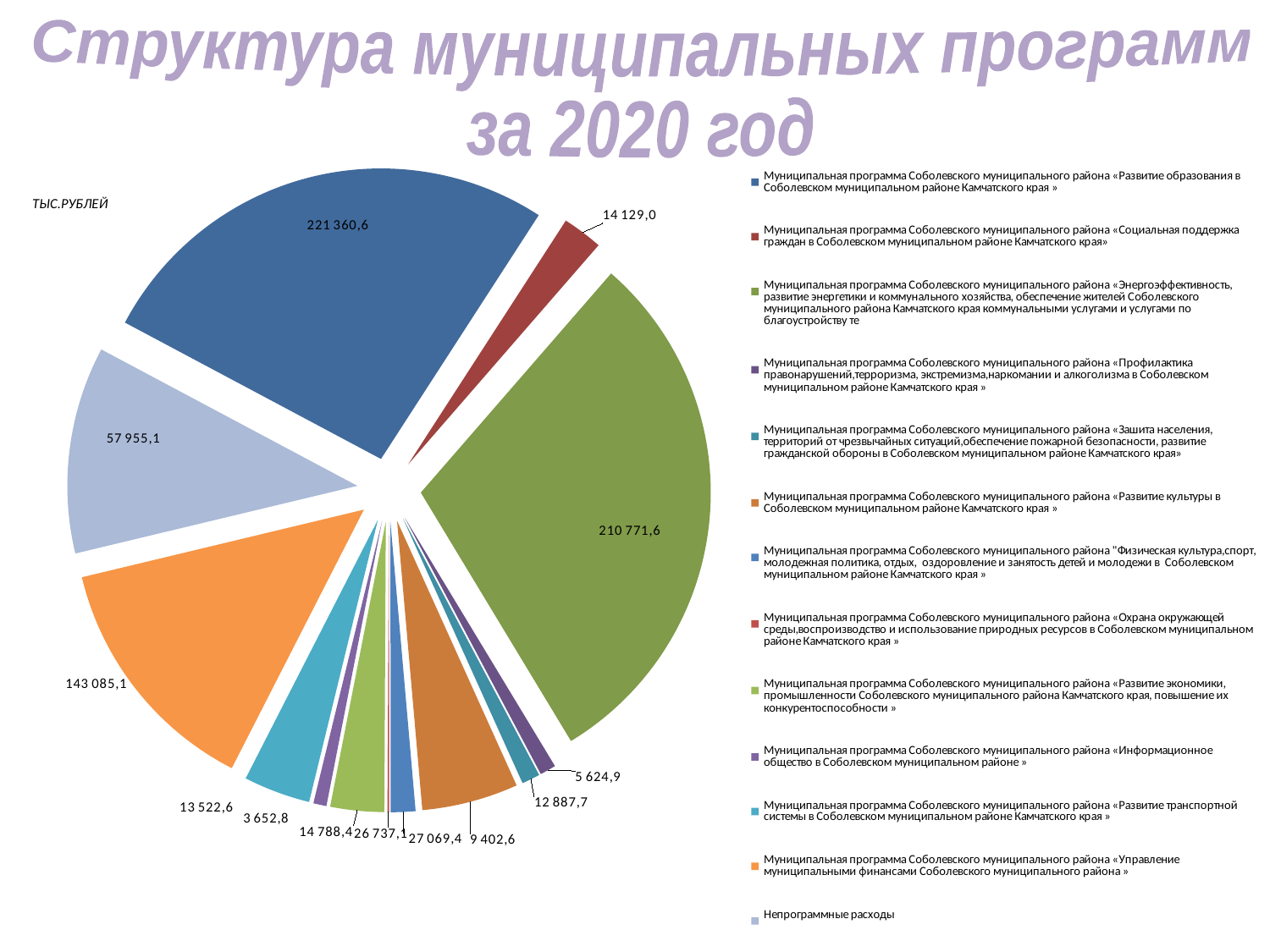
Which is larger: the value for «Управление муниципальными финансами» or Непрограммные расходы? Управление муниципальными финансами How many slices does the pie chart have? 13 What kind of chart is shown on the slide? pie chart What is the value for the municipal program «Социальная поддержка граждан в Соболевском муниципальном районе Камчатского края»? 14 129,0 What is the value for the municipal program «Развитие образования в Соболевском муниципальном районе Камчатского края»? 221 360,6 What is the value for the municipal program «Управление муниципальными финансами Соболевского муниципального района»? 143 085,1 What is the value for the municipal program «Энергоэффективность, развитие энергетики и коммунального хозяйства...»? 210 771,6 In what units are the values on the pie chart given, according to the label on the slide? ТЫС.РУБЛЕЙ What is the difference between the value for «Развитие образования» (221 360,6) and «Энергоэффективность...» (210 771,6)? 10 589,0 What is the value for Непрограммные расходы? 57 955,1 Which slice has the smallest value in the pie chart? Охрана окружающей среды, воспроизводство и использование природных ресурсов в Соболевском муниципальном районе Камчатского края